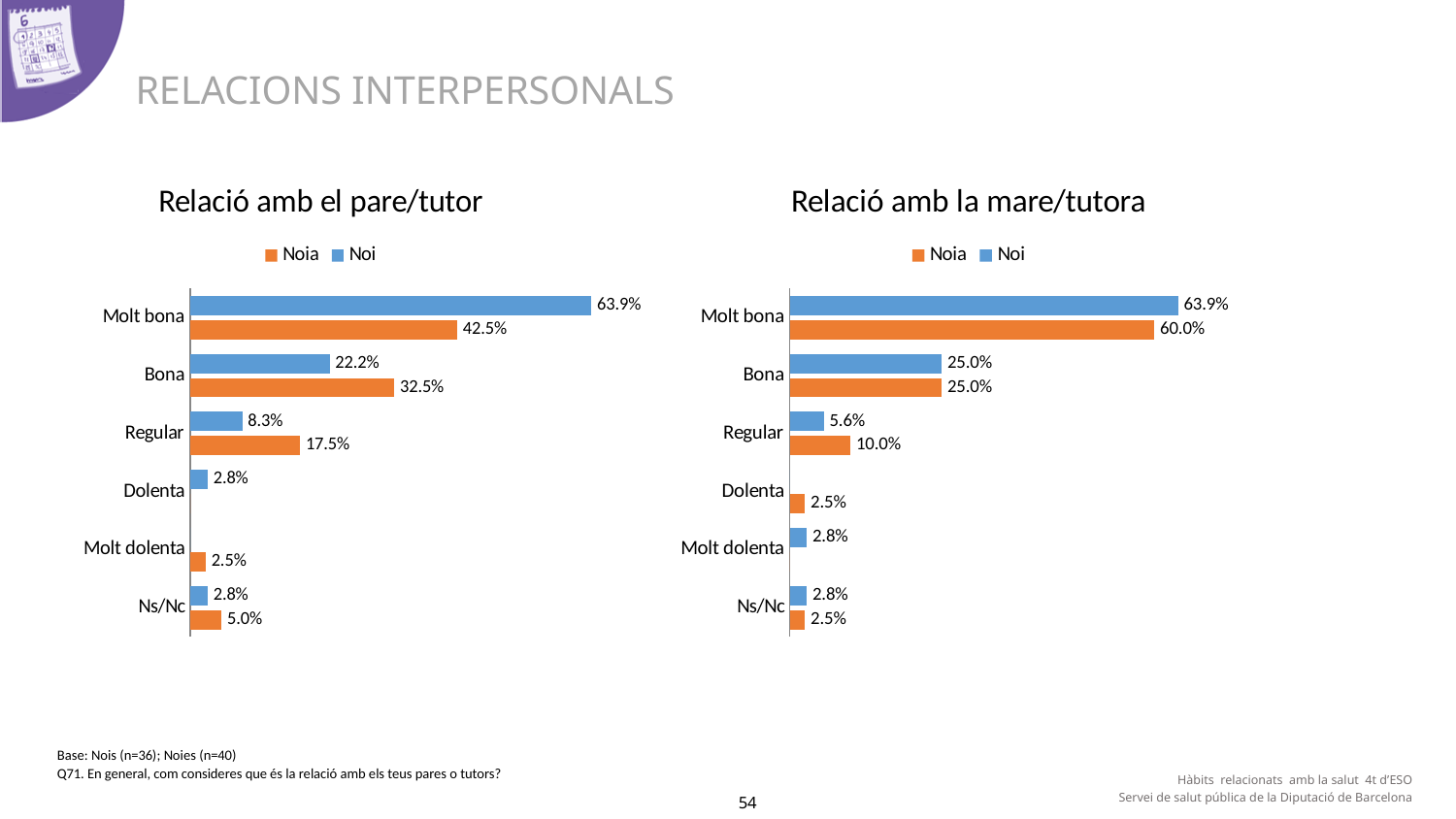
In the 'Relació amb la mare/tutora' chart, what is the value for Noi in the Ns/Nc category? 2.8% How many series does the legend of the 'Relació amb la mare/tutora' chart list? 2 In the 'Relació amb la mare/tutora' chart, what is the value for Noia in the Regular category? 10.0% In the 'Relació amb el pare/tutor' chart, which category has the highest value for Noia? Molt bona In the 'Relació amb la mare/tutora' chart, what is the difference between the Noi and Noia values for Molt bona? 3.9% How many categories are shown on the 'Relació amb el pare/tutor' chart? 6 In the 'Relació amb la mare/tutora' chart, which category has the lowest value for Noi? Dolenta What type of chart is 'Relació amb la mare/tutora'? Bar chart In the 'Relació amb el pare/tutor' chart, what is the difference between the Noi and Noia values for Molt bona? 21.4% In the 'Relació amb el pare/tutor' chart, what is the value for Noia in the Bona category? 32.5% In the 'Relació amb el pare/tutor' chart, what is the value for Noi in the Molt bona category? 63.9% In the 'Relació amb el pare/tutor' chart, which is larger for the Regular category, Noia or Noi? Noia